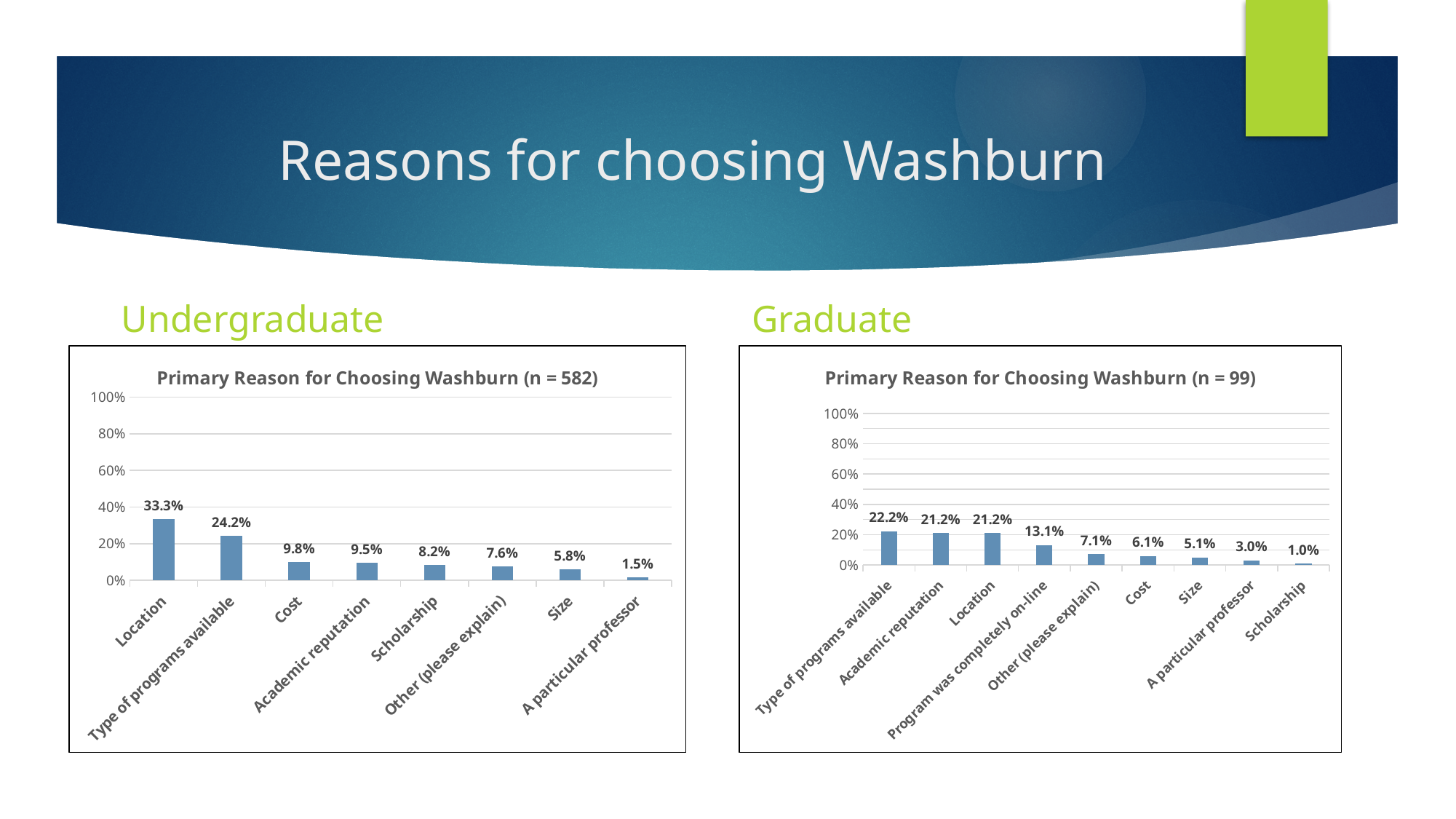
In the Graduate chart, what percentage chose Program was completely on-line? 13.1% What is the sample size (n) given in the title of the Undergraduate chart? 582 In the Undergraduate chart, what is the difference between Location and Type of programs available? 9.1% In the Undergraduate chart, which reason has the highest percentage? Location How many categories are shown in the Graduate chart? 9 In the Graduate chart, which reason has the lowest percentage? Scholarship How many categories are shown in the Undergraduate chart? 8 In the Undergraduate chart, what percentage chose Location as their primary reason? 33.3% In the Undergraduate chart, is the value for Location greater or less than 40%? less In the Graduate chart, do the values rise or fall from left to right? Fall In the Graduate chart, which is larger: Cost or Size? Cost What kind of chart is the Graduate chart? Bar chart